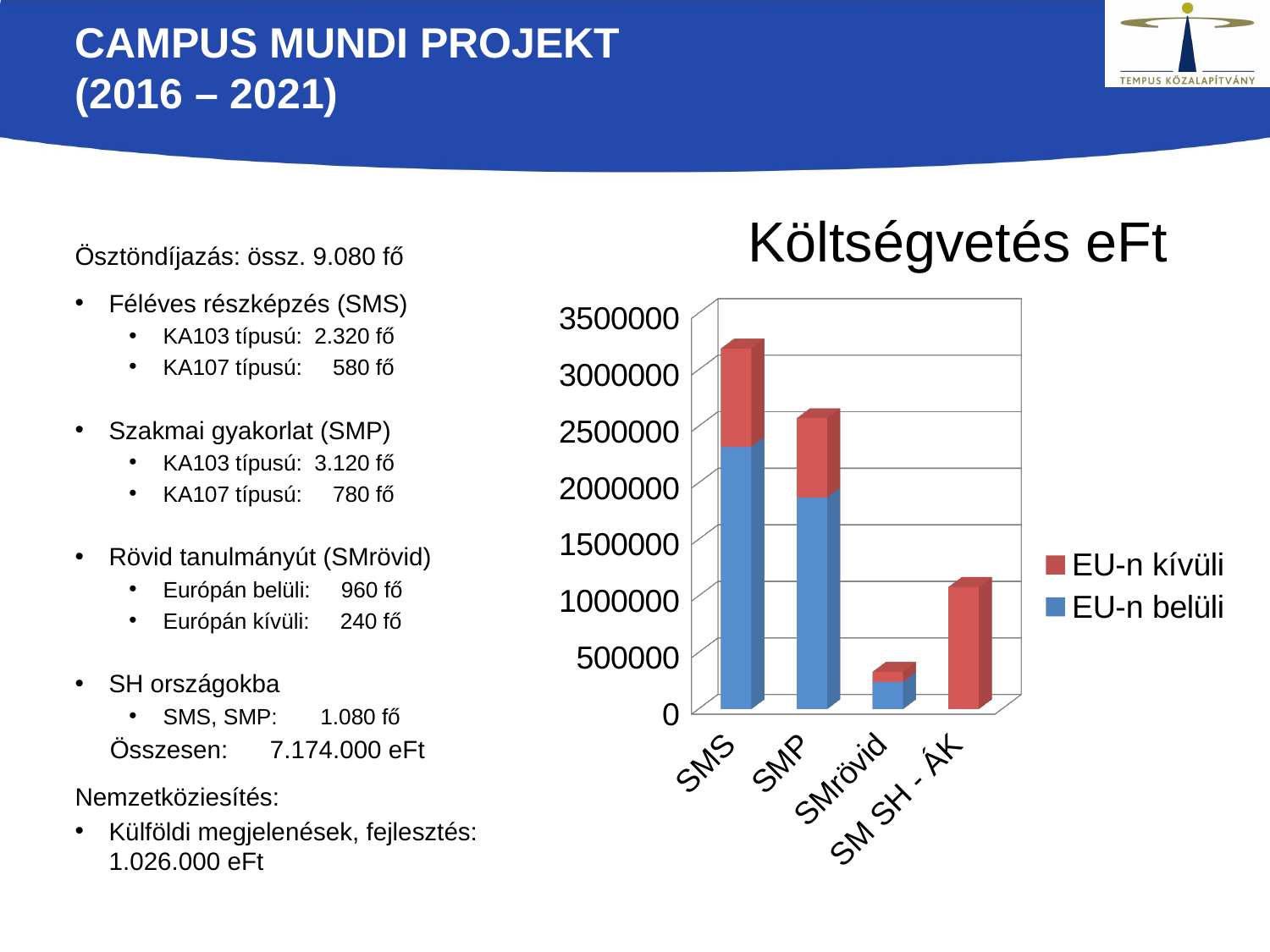
What kind of chart is shown on the slide? stacked bar chart Is the total value for SMrövid greater or less than 500000? less Which bar is taller, SMrövid or SM SH - ÁK? SM SH - ÁK What is the title of the chart? Költségvetés eFt Is the total value for SMS greater or less than 3000000? greater Which colour represents the EU-n belüli series in the chart? blue Is the total value for SMP greater or less than 3000000? less How many categories are shown on the x axis of the chart? 4 Which bar is taller, SMS or SMP? SMS Which category has the tallest bar in the chart? SMS Which category has the shortest bar in the chart? SMrövid How many series does the chart legend list? 2